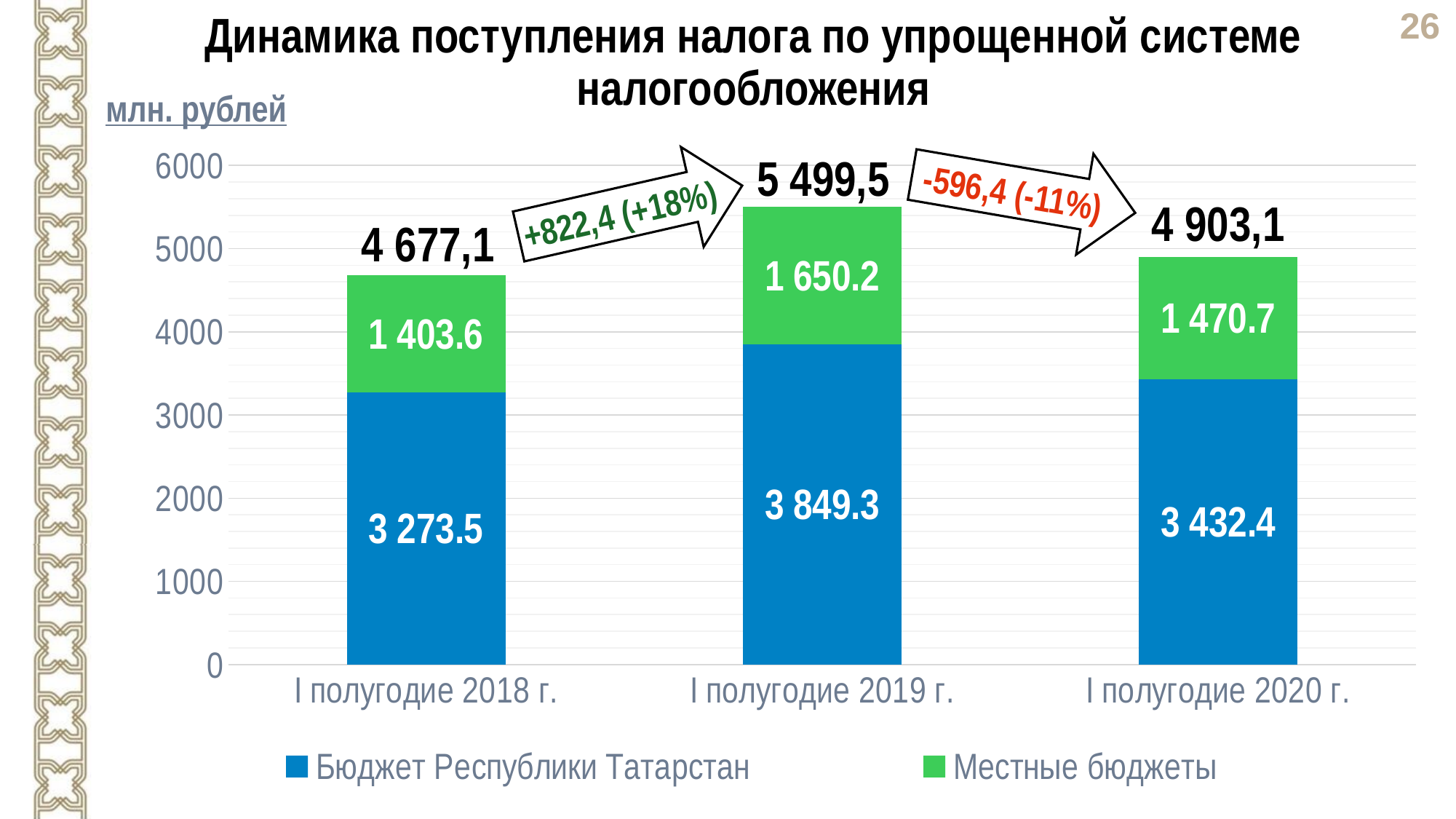
What is the difference between the Бюджет Республики Татарстан values for I полугодие 2019 г. and I полугодие 2020 г.? 416.9 How many periods are shown on the x axis? 3 What is the value for Бюджет Республики Татарстан in I полугодие 2019 г.? 3 849.3 What is the total of the stacked bar for I полугодие 2018 г.? 4 677,1 Which period has the lowest value for Местные бюджеты? I полугодие 2018 г. What kind of chart is shown on the slide? Stacked bar chart How many series does the legend list? 2 Which is larger: Местные бюджеты in I полугодие 2019 г. or in I полугодие 2020 г.? I полугодие 2019 г. Which period has the highest value for Бюджет Республики Татарстан? I полугодие 2019 г. What is the value for Местные бюджеты in I полугодие 2020 г.? 1 470.7 What is the total of the stacked bar for I полугодие 2019 г.? 5 499,5 What is the value for Местные бюджеты in I полугодие 2018 г.? 1 403.6